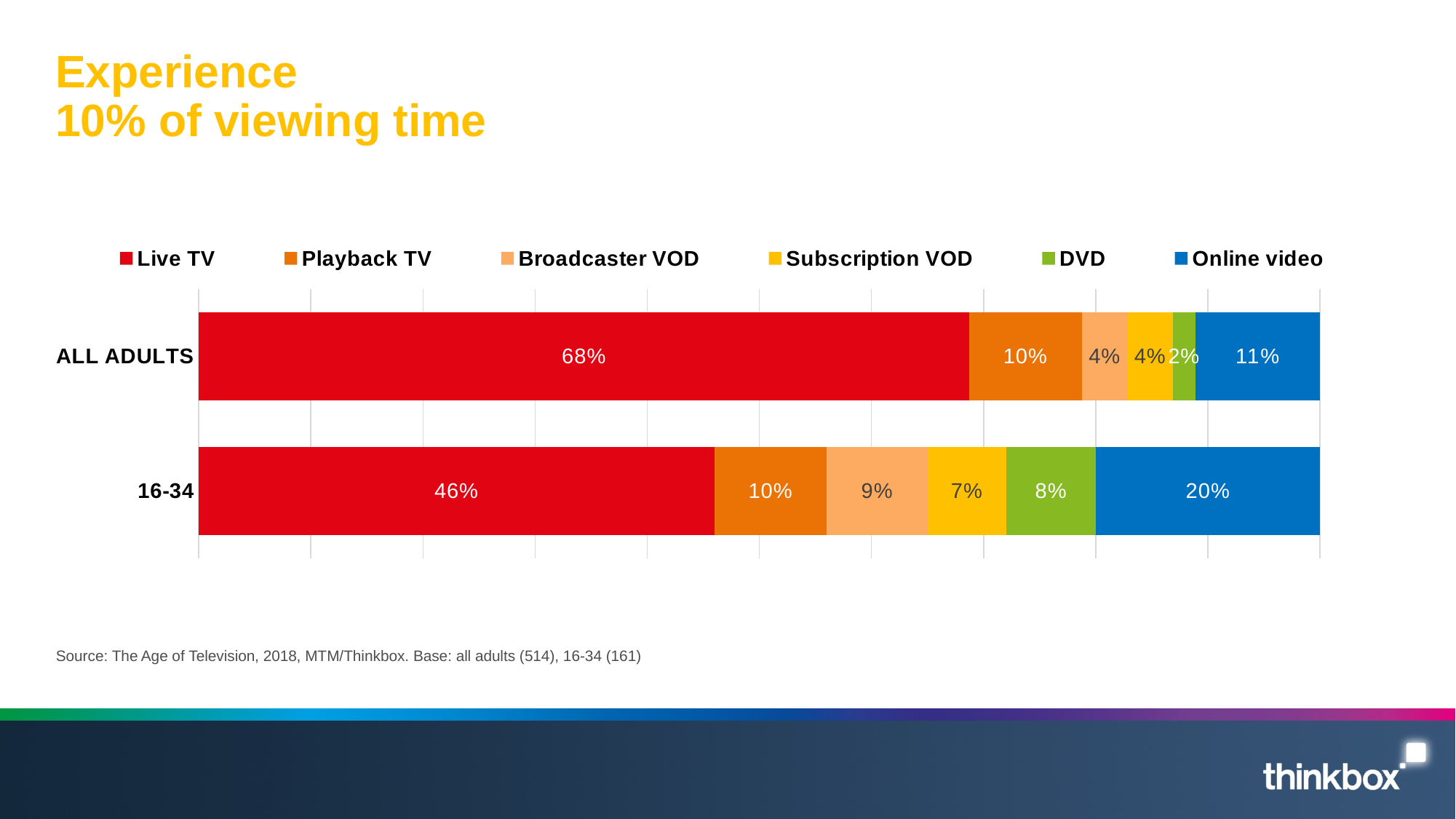
What is the total of the stacked bar for the 16-34 group? 100% What share of viewing time is Online video for the 16-34 group? 20% What is the DVD value for ALL ADULTS? 2% Which series has the largest share for the 16-34 group? Live TV How many series does the legend list? 6 What is the difference between the Live TV share for ALL ADULTS and for 16-34? 22% Which series has the smallest share for ALL ADULTS? DVD How many categories (bars) are shown in the chart? 2 What kind of chart is shown on the slide? Stacked bar chart What share of viewing time is Live TV for ALL ADULTS? 68% What is the Broadcaster VOD value for the 16-34 group? 9% Which group has the larger Online video share, ALL ADULTS or 16-34? 16-34